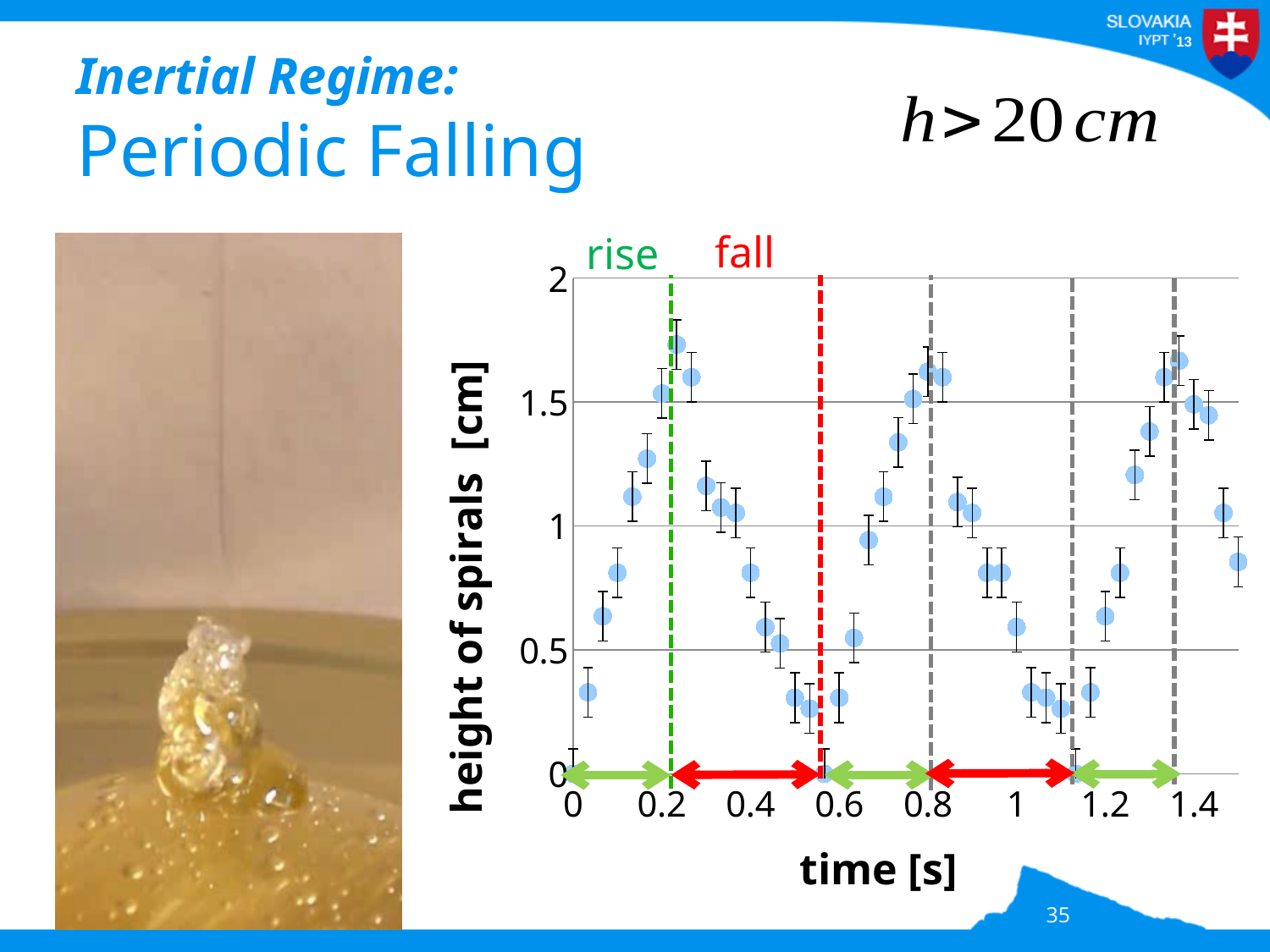
Is the height of spirals at time 0 s greater or less than 0.5 cm? less What is the label of the x axis of the chart? time [s] Is the height of spirals at about 0.4 s greater or less than 1 cm? less Between 0 s and 0.2 s, do the plotted heights rise or fall? rise Is the height of spirals at about 0.8 s greater or less than 1.5 cm? greater How many peaks (maxima) does the plotted height show between 0 s and 1.4 s? 3 What is the label of the y axis of the chart? height of spirals [cm] What kind of chart is shown on the slide? scatter chart Between 0.2 s and 0.55 s, do the plotted heights rise or fall? fall